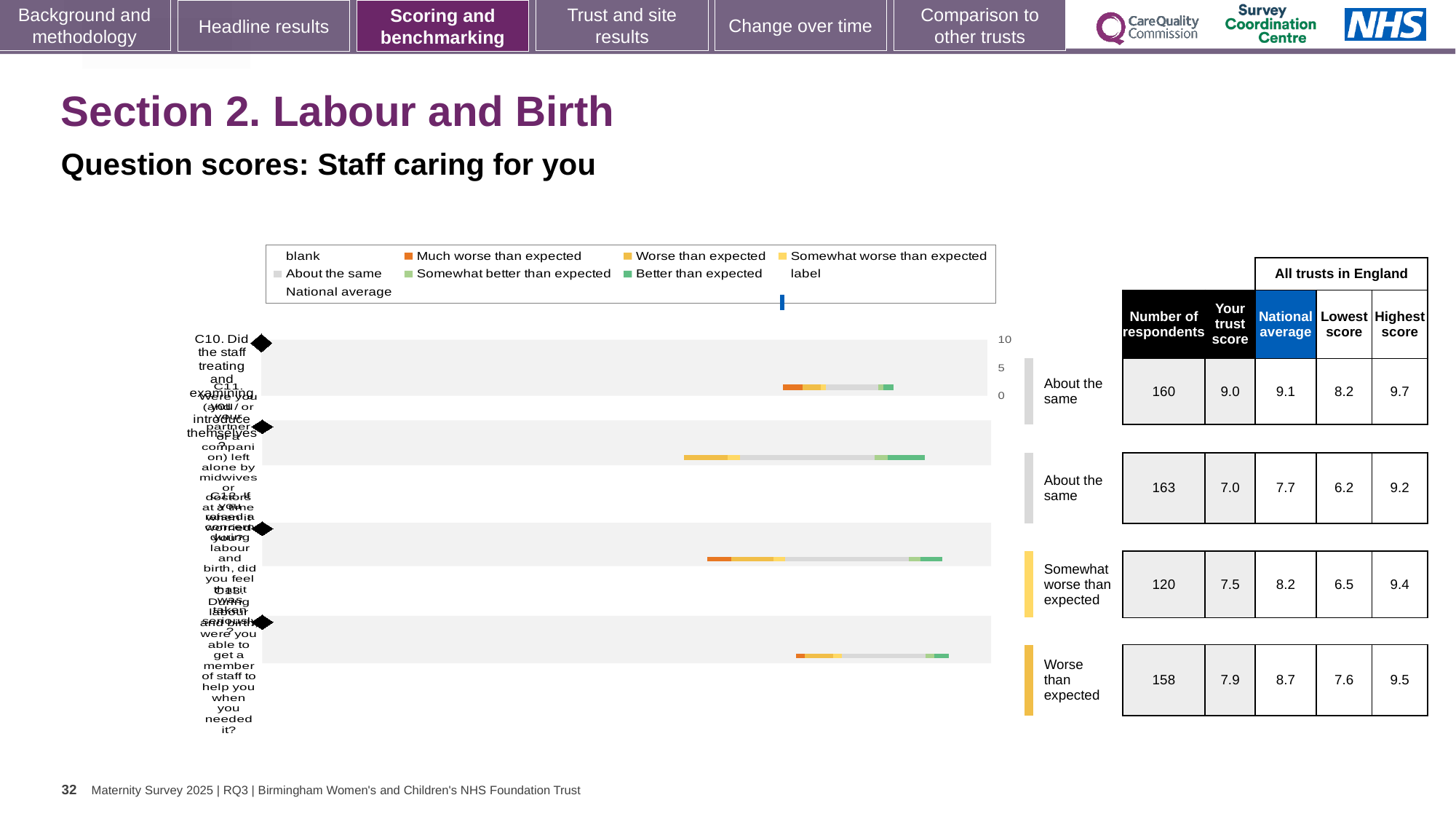
What kind of chart is shown on the slide? Bar chart Which question row has the lowest number of respondents? The third row (120) For the fourth (bottom) question row, what is the difference between the national average and the trust score? 0.8 In the table beside the chart, what is the number of respondents for the first (top) question row? 160 What colour does the legend use for 'Much worse than expected'? Orange What is the highest score among all trusts in England for the fourth (bottom) question row? 9.5 What is the 'Your trust score' value for the second question row? 7.0 What is the national average for the third question row? 8.2 Which question row has the highest number of respondents? The second row (163) How many question rows (bars) are plotted in the chart? 4 What benchmark rating label is shown next to the fourth (bottom) question row? Worse than expected Which has the higher trust score: the first question row or the second question row? The first row